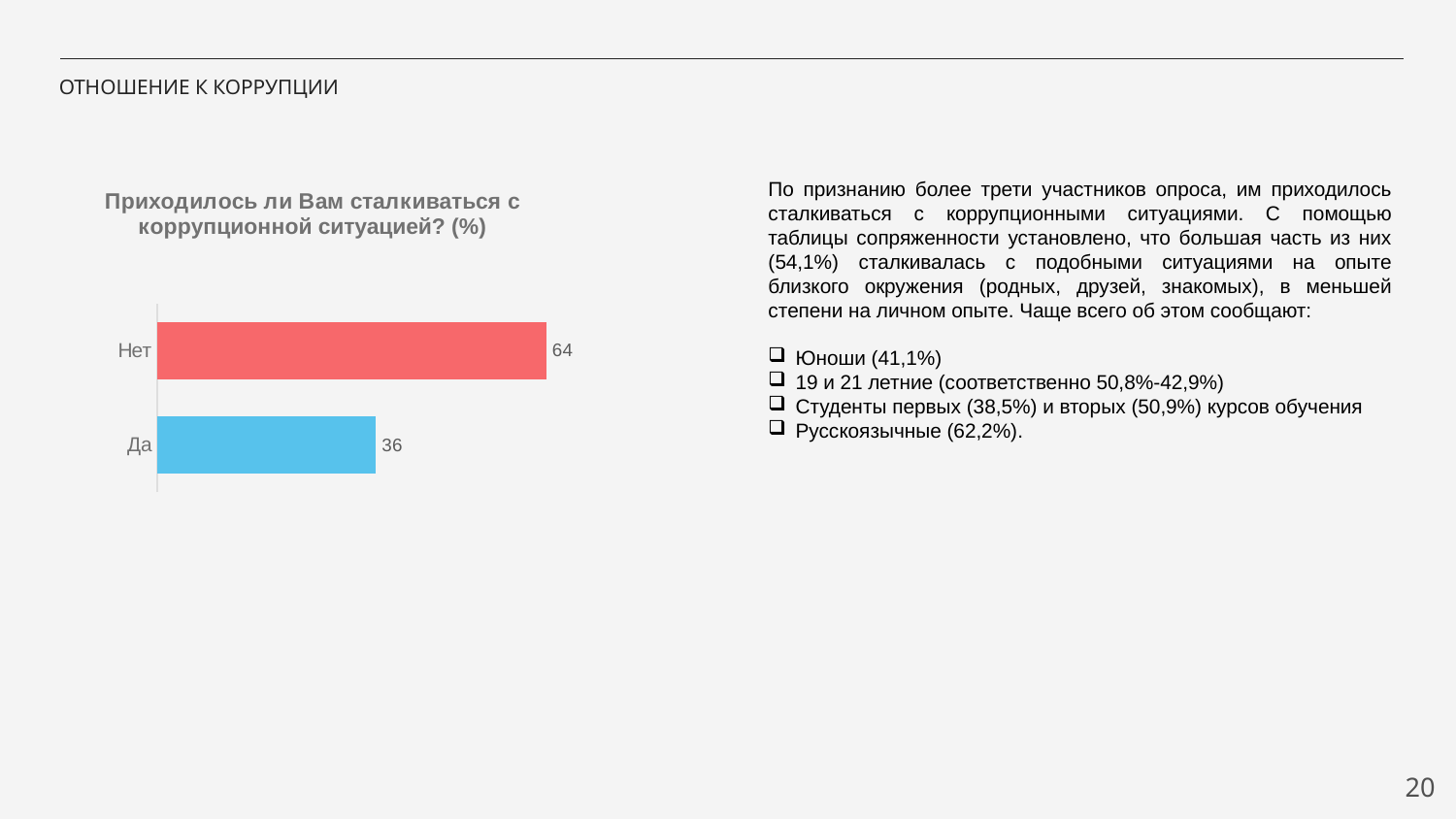
Which category has the lowest value? Да How many categories are shown in the chart? 2 What is the title of the chart? Приходилось ли Вам сталкиваться с коррупционной ситуацией? (%) What is the total of the two values shown in the chart? 100 What is the value for "Нет"? 64 What kind of chart is shown on the slide? Bar chart What is the value for "Да"? 36 Which is larger, the value for "Да" or the value for "Нет"? Нет What colour is the bar for "Да"? Blue Which category has the highest value? Нет What is the difference between the values for "Нет" and "Да"? 28